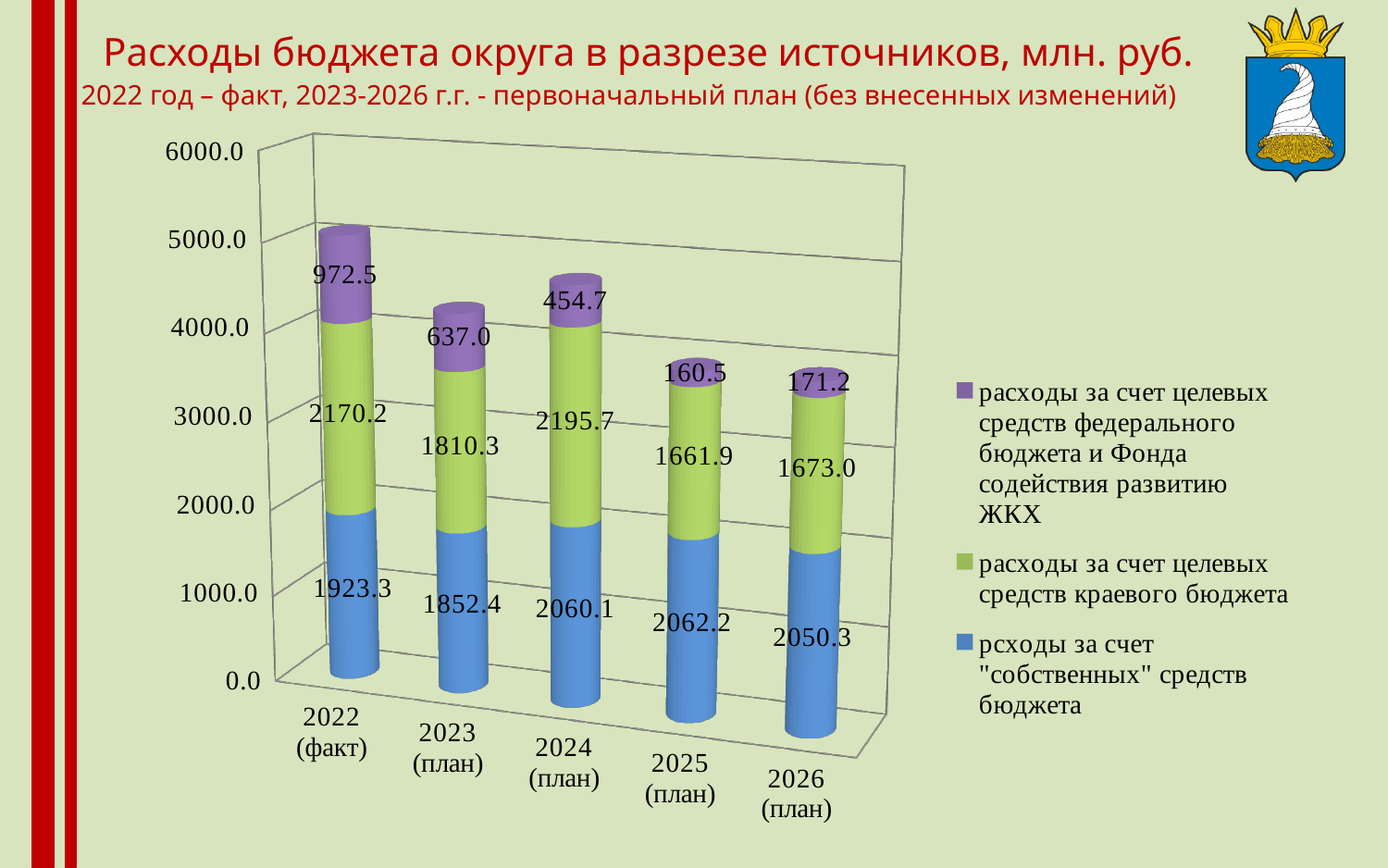
In which year is the value for 'расходы за счет целевых средств федерального бюджета и Фонда содействия развитию ЖКХ' the highest? 2022 (факт) What is the total of the stacked bar for 2023 (план)? 4299.7 How many series does the legend list? 3 What is the value for 'расходы за счет целевых средств федерального бюджета и Фонда содействия развитию ЖКХ' in 2022 (факт)? 972.5 In which year is the value for 'расходы за счет целевых средств федерального бюджета и Фонда содействия развитию ЖКХ' the lowest? 2025 (план) What kind of chart is shown on the slide? Stacked bar chart What is the value for 'рсходы за счет "собственных" средств бюджета' in 2026 (план)? 2050.3 How many years are shown on the x axis? 5 Which is larger: the 'расходы за счет целевых средств краевого бюджета' value for 2024 (план) or for 2025 (план)? 2024 (план) What is the value for 'расходы за счет целевых средств краевого бюджета' in 2024 (план)? 2195.7 What is the total of the stacked bar for 2022 (факт)? 5066.0 What is the difference between the 'расходы за счет целевых средств краевого бюджета' values for 2022 (факт) and 2023 (план)? 359.9